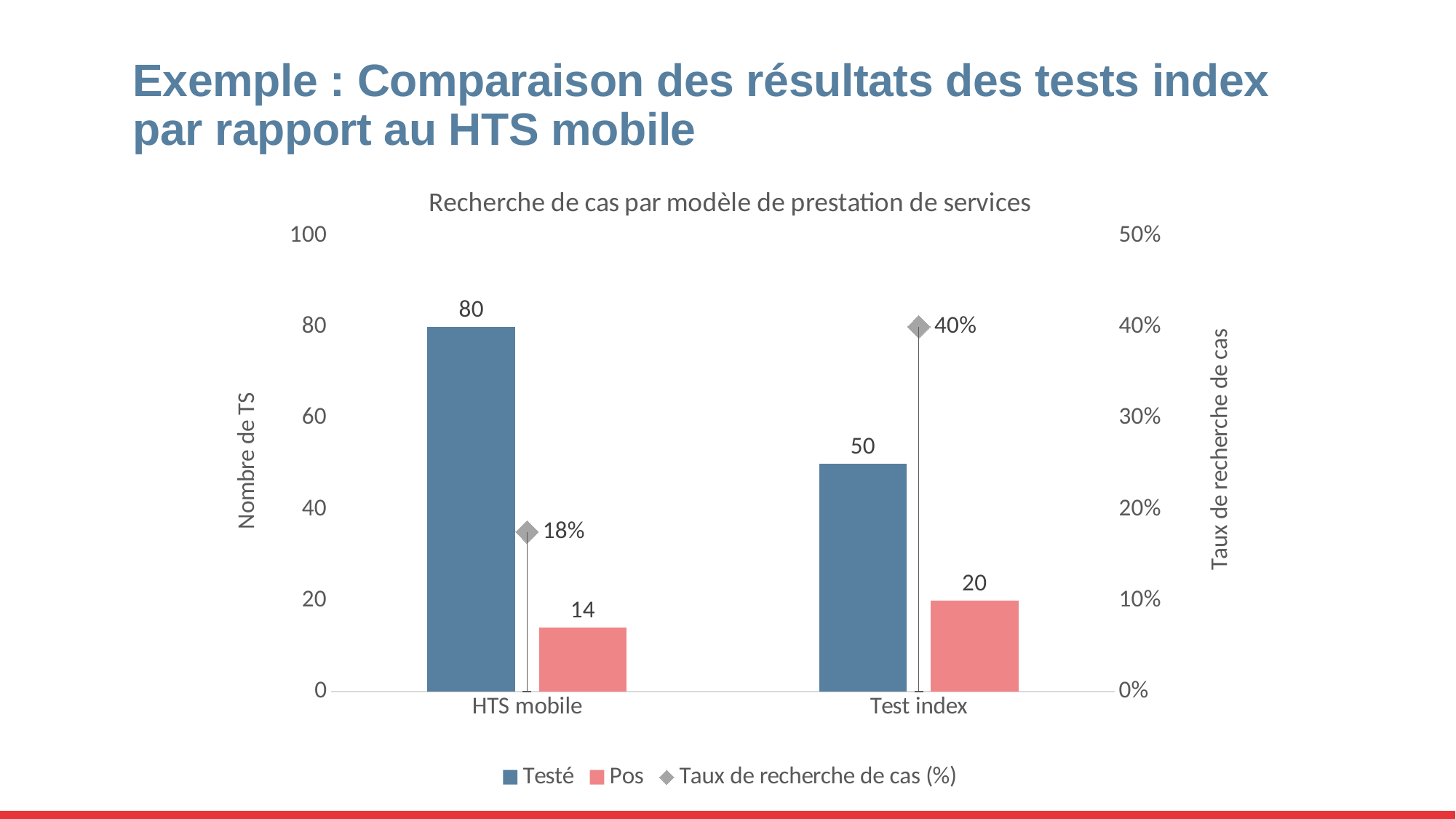
Which category has the lower Pos value? HTS mobile What is the difference between the Testé values for HTS mobile and Test index? 30 What is the title of the chart? Recherche de cas par modèle de prestation de services What is the difference between the Pos values for Test index and HTS mobile? 6 What is the Testé value for HTS mobile? 80 Is the Taux de recherche de cas (%) higher for HTS mobile or Test index? Test index What is the Taux de recherche de cas (%) for HTS mobile? 18% How many categories are shown on the x axis? 2 What is the Pos value for Test index? 20 What is the Taux de recherche de cas (%) for Test index? 40% Which category has the higher Testé value? HTS mobile How many series does the legend list? 3